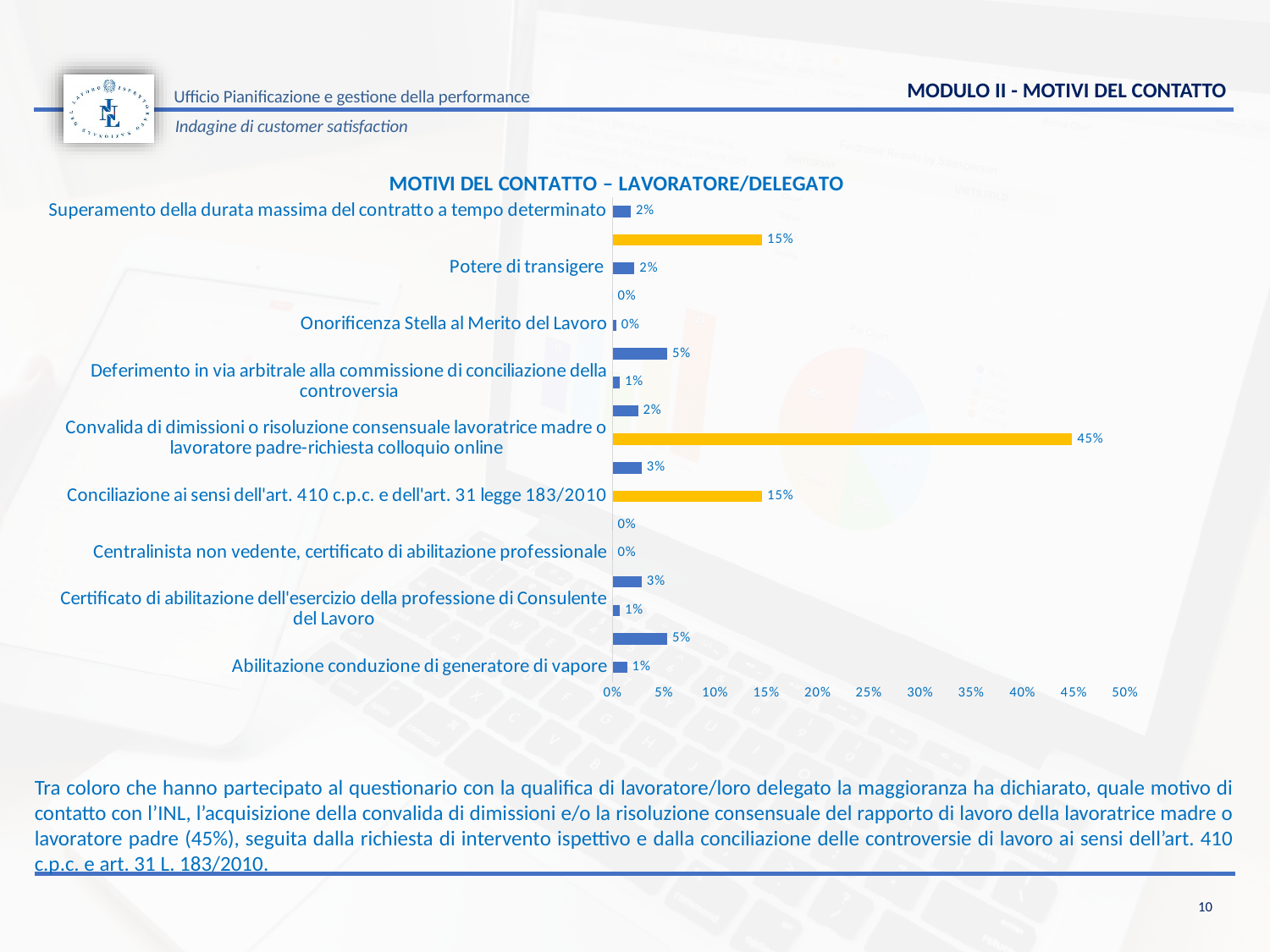
Is the value for 'Convalida di dimissioni o risoluzione consensuale lavoratrice madre o lavoratore padre-richiesta colloquio online' greater or less than 40%? greater What is the value for 'Potere di transigere'? 2% Which category has the highest value? Convalida di dimissioni o risoluzione consensuale lavoratrice madre o lavoratore padre-richiesta colloquio online What is the value for 'Conciliazione ai sensi dell'art. 410 c.p.c. e dell'art. 31 legge 183/2010'? 15% Which is larger: the value for 'Conciliazione ai sensi dell'art. 410 c.p.c. e dell'art. 31 legge 183/2010' or the value for 'Potere di transigere'? Conciliazione ai sensi dell'art. 410 c.p.c. e dell'art. 31 legge 183/2010 What is the difference between the value for 'Convalida di dimissioni o risoluzione consensuale lavoratrice madre o lavoratore padre-richiesta colloquio online' and the value for 'Conciliazione ai sensi dell'art. 410 c.p.c. e dell'art. 31 legge 183/2010'? 30% What type of chart is shown on the slide? bar chart What is the highest value shown on the x axis? 50% What is the value for 'Abilitazione conduzione di generatore di vapore'? 1% What is the title of the chart? MOTIVI DEL CONTATTO – LAVORATORE/DELEGATO What is the value for 'Convalida di dimissioni o risoluzione consensuale lavoratrice madre o lavoratore padre-richiesta colloquio online'? 45% What is the value for 'Onorificenza Stella al Merito del Lavoro'? 0%